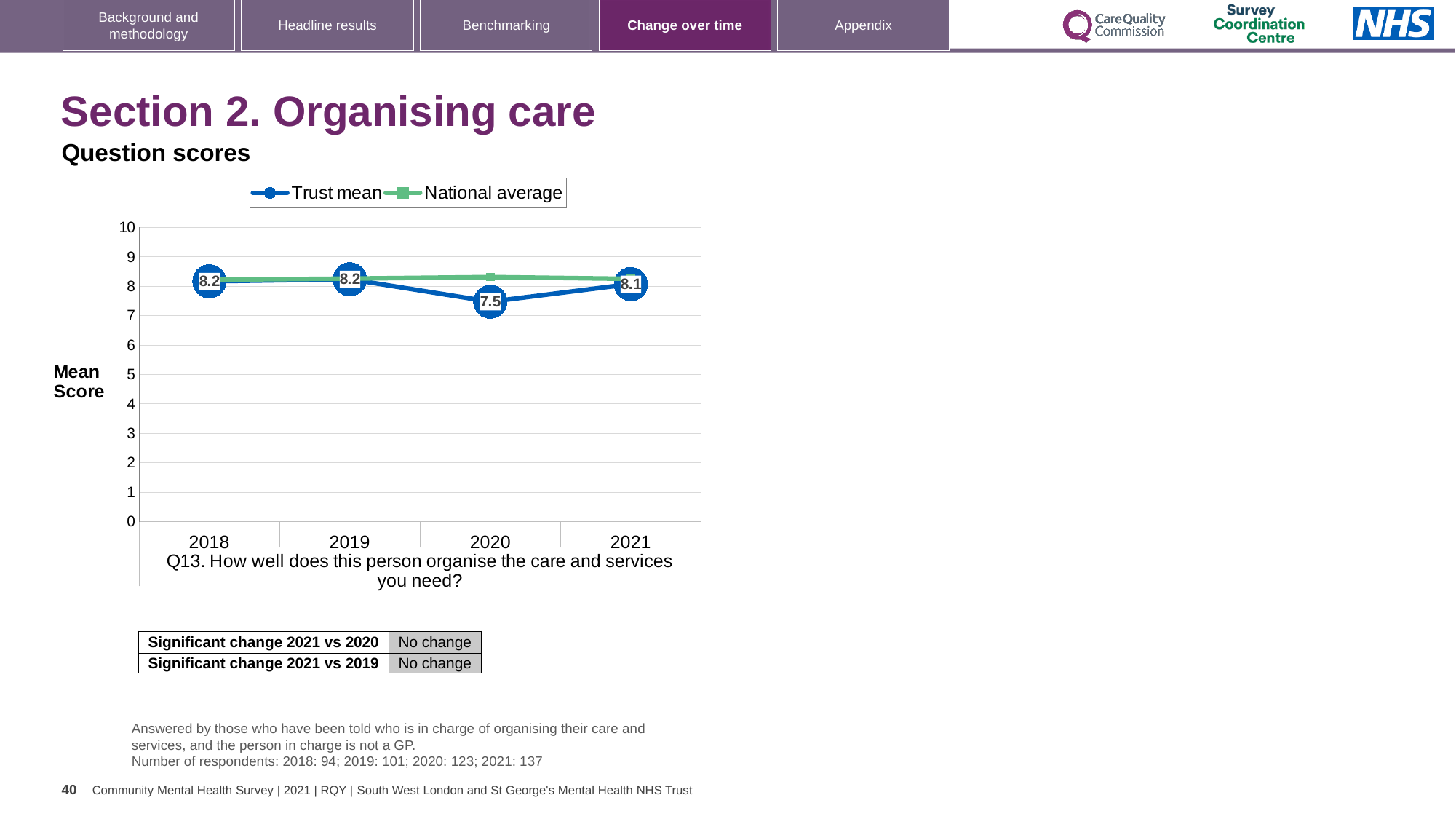
In which year is the Trust mean lowest? 2020 What is the Trust mean for 2018? 8.2 In 2020, which is higher: the Trust mean or the National average? National average Is the National average for 2020 greater or less than 8? greater What is the Trust mean for 2020? 7.5 How many series does the legend list? 2 What is the label on the y axis of the chart? Mean Score Is the Trust mean for 2020 greater or less than 8? less What is the Trust mean for 2021? 8.1 How many years are shown on the x axis? 4 What is the difference between the Trust mean in 2019 and in 2020? 0.7 What kind of chart is shown? Line chart